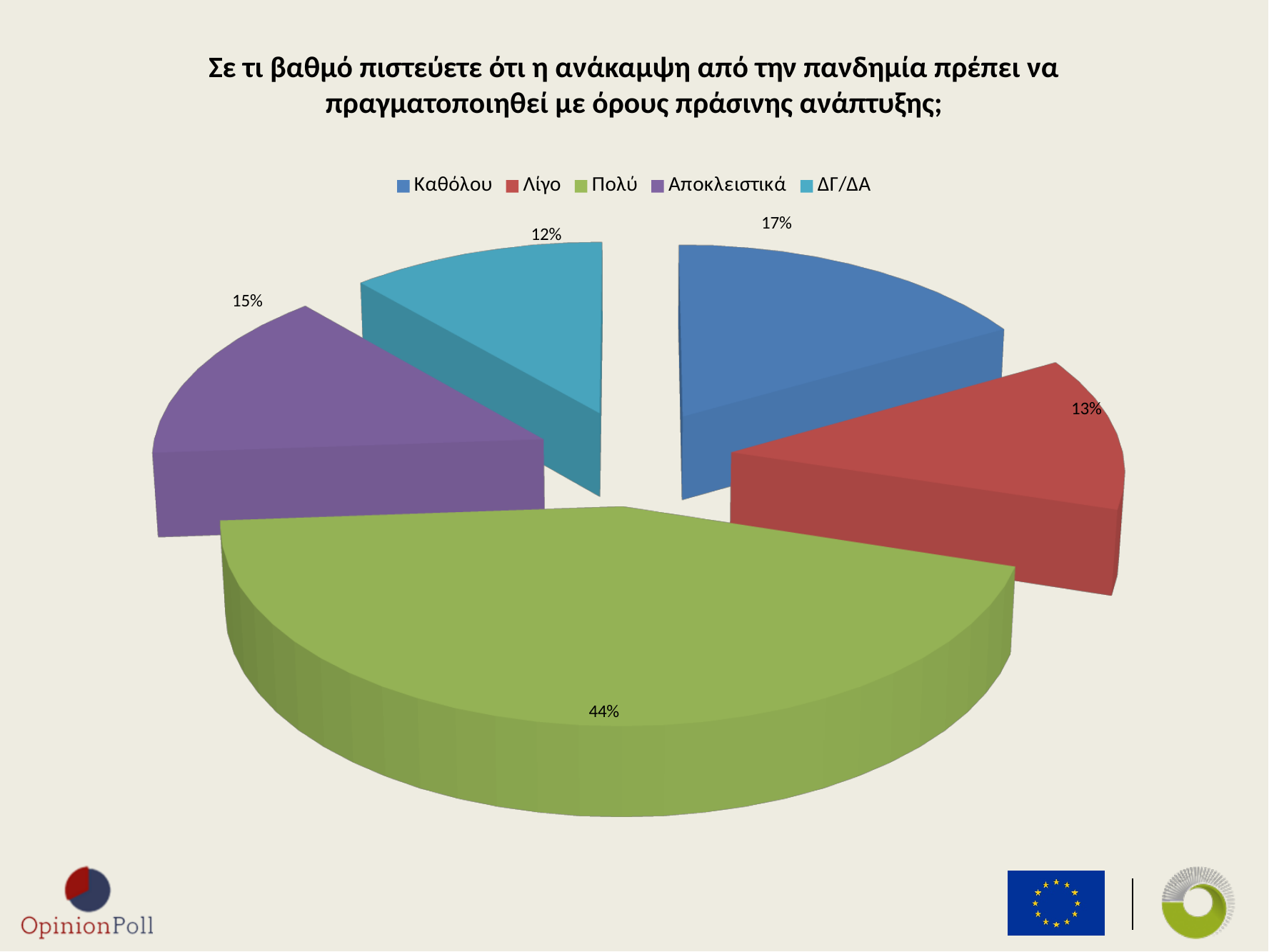
Which is larger, the share for Αποκλειστικά or the share for Λίγο? Αποκλειστικά What colour is the slice for Πολύ? Green What percentage of respondents answered Καθόλου? 17% How many categories does the legend list? 5 What percentage of respondents answered Λίγο? 13% What is the difference in percentage points between Πολύ and Καθόλου? 27 What percentage of respondents answered ΔΓ/ΔΑ? 12% What percentage of respondents answered Αποκλειστικά? 15% What kind of chart is shown on the slide? Pie chart What percentage of respondents answered Πολύ? 44% Which response category has the smallest share of the pie? ΔΓ/ΔΑ Which response category has the largest share of the pie? Πολύ